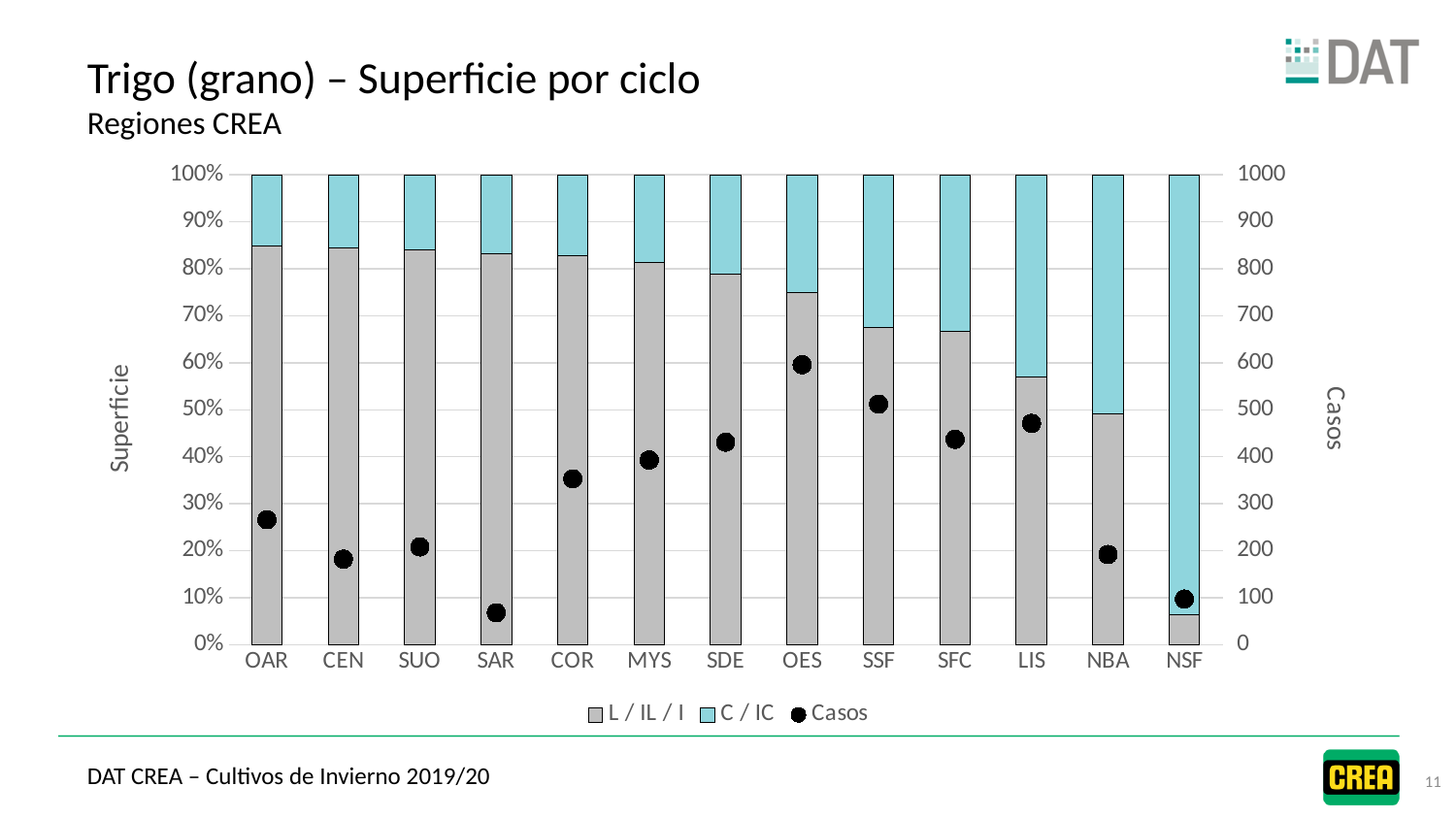
How many series does the chart legend list? 3 Which region has more Casos, SSF or SFC? SSF Which region has the highest number of Casos? OES What kind of chart is shown on the slide? bar chart How many regions are shown along the x axis of the chart? 13 Which region has the largest C / IC share of Superficie? NSF Is the number of Casos for OES greater or less than 500? greater Is the L / IL / I share for OES greater or less than 70%? greater Which region has the lowest number of Casos? SAR What is the title of the right-hand vertical axis? Casos Is the number of Casos for SAR greater or less than 100? less Which region has the smallest L / IL / I share of Superficie? NSF